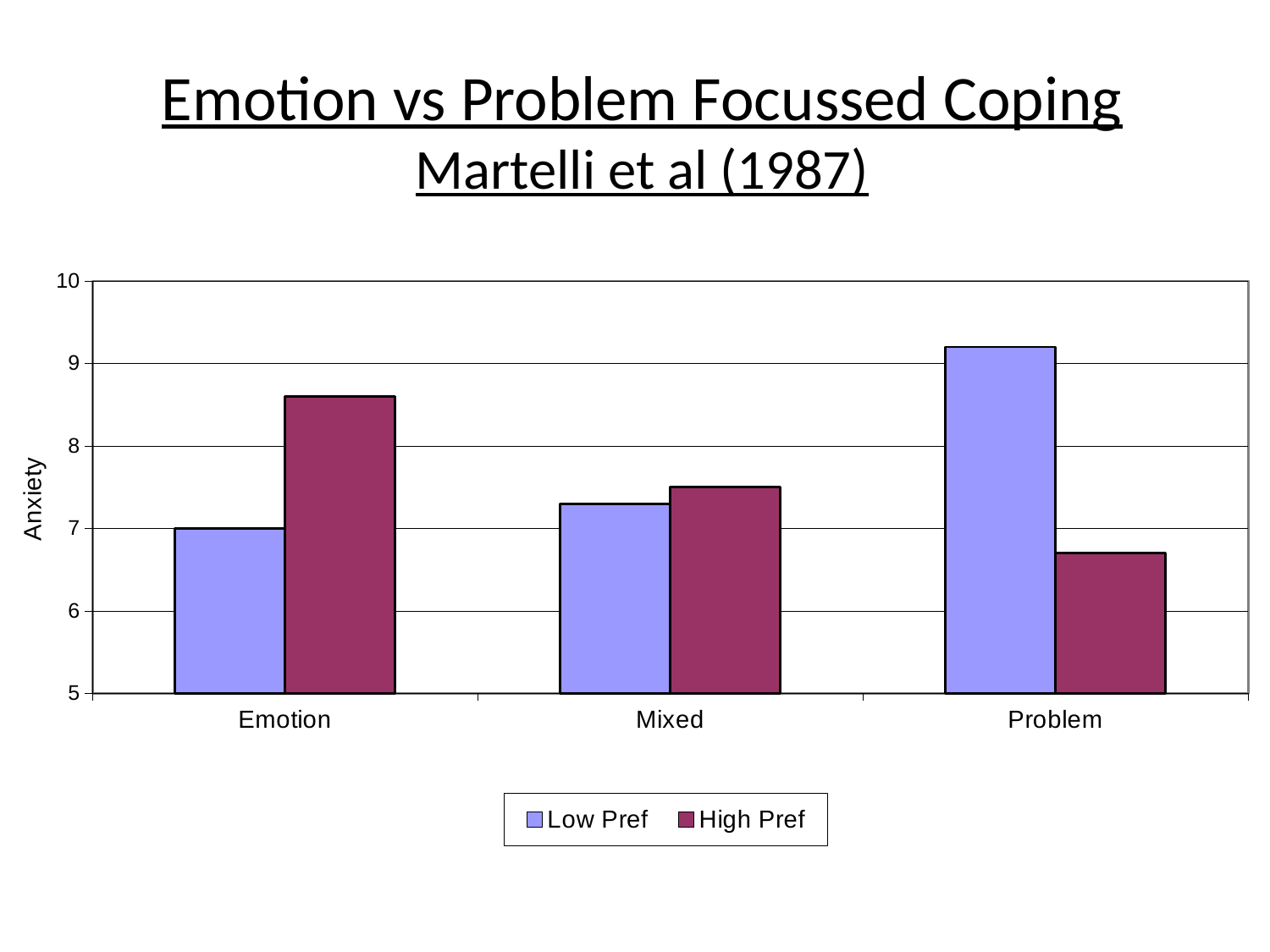
Which category has the lowest High Pref value? Problem What is the Low Pref anxiety value for the Emotion category? 7 Which category has the highest Low Pref value? Problem Is the High Pref value for Problem greater or less than 7? less Is the High Pref value for Emotion greater or less than 8? greater Is the Low Pref value for Mixed greater or less than 8? less What kind of chart is shown on the slide? bar chart How many series does the legend list? 2 How many categories are shown on the x axis? 3 For the Emotion category, which is larger: Low Pref or High Pref? High Pref What is the label on the vertical axis? Anxiety